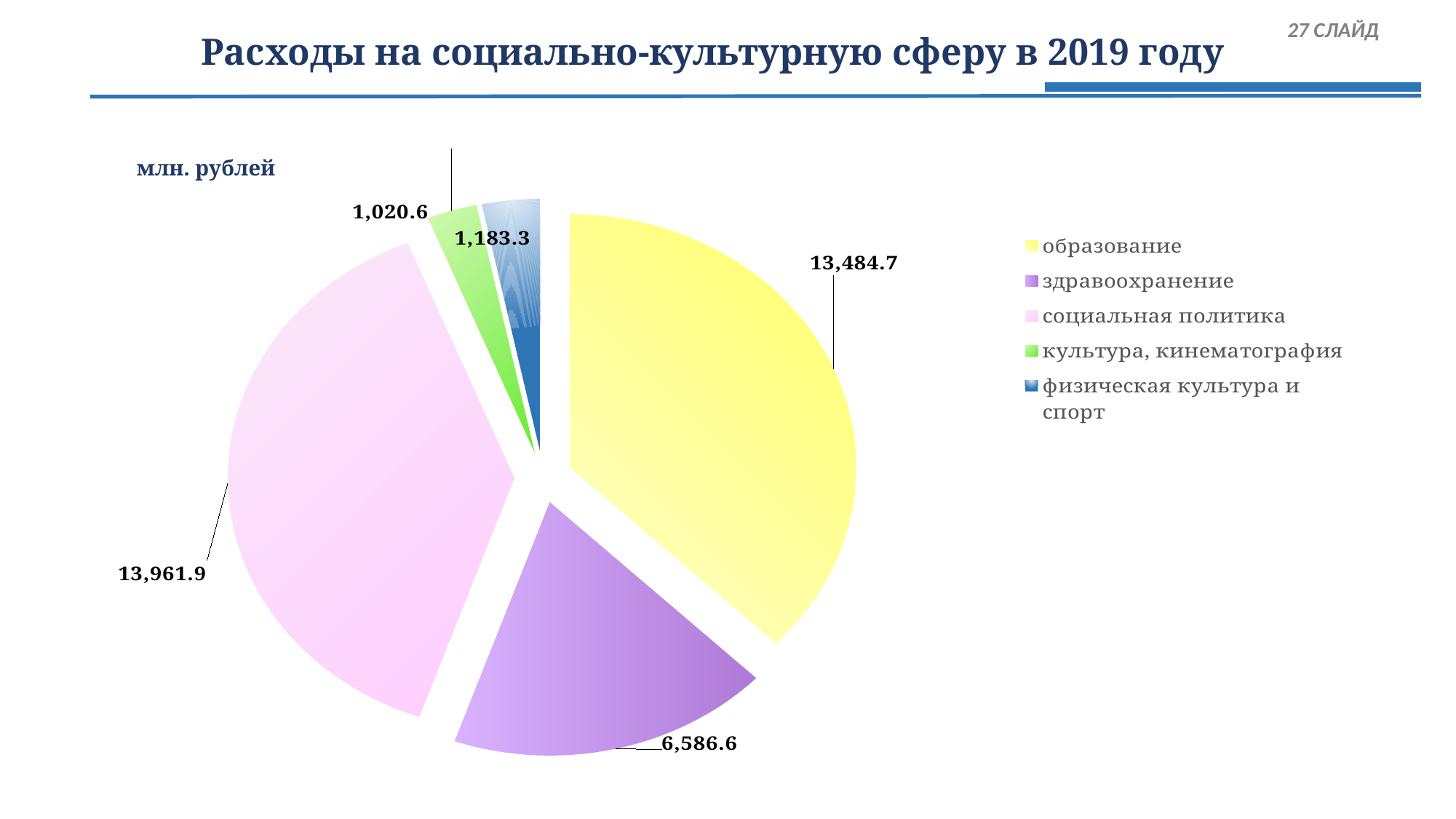
What is the value for здравоохранение? 6,586.6 What is the value for физическая культура и спорт? 1,183.3 Which is larger, the value for образование or the value for здравоохранение? образование What is the value for социальная политика? 13,961.9 What is the difference between the values for социальная политика and образование? 477.2 Which category has the largest value? социальная политика What is the value for образование? 13,484.7 How many categories does the pie chart show? 5 Which category has the smallest value? культура, кинематография What kind of chart is shown on the slide? pie chart What is the value for культура, кинематография? 1,020.6 What unit is stated for the values on the chart? млн. рублей